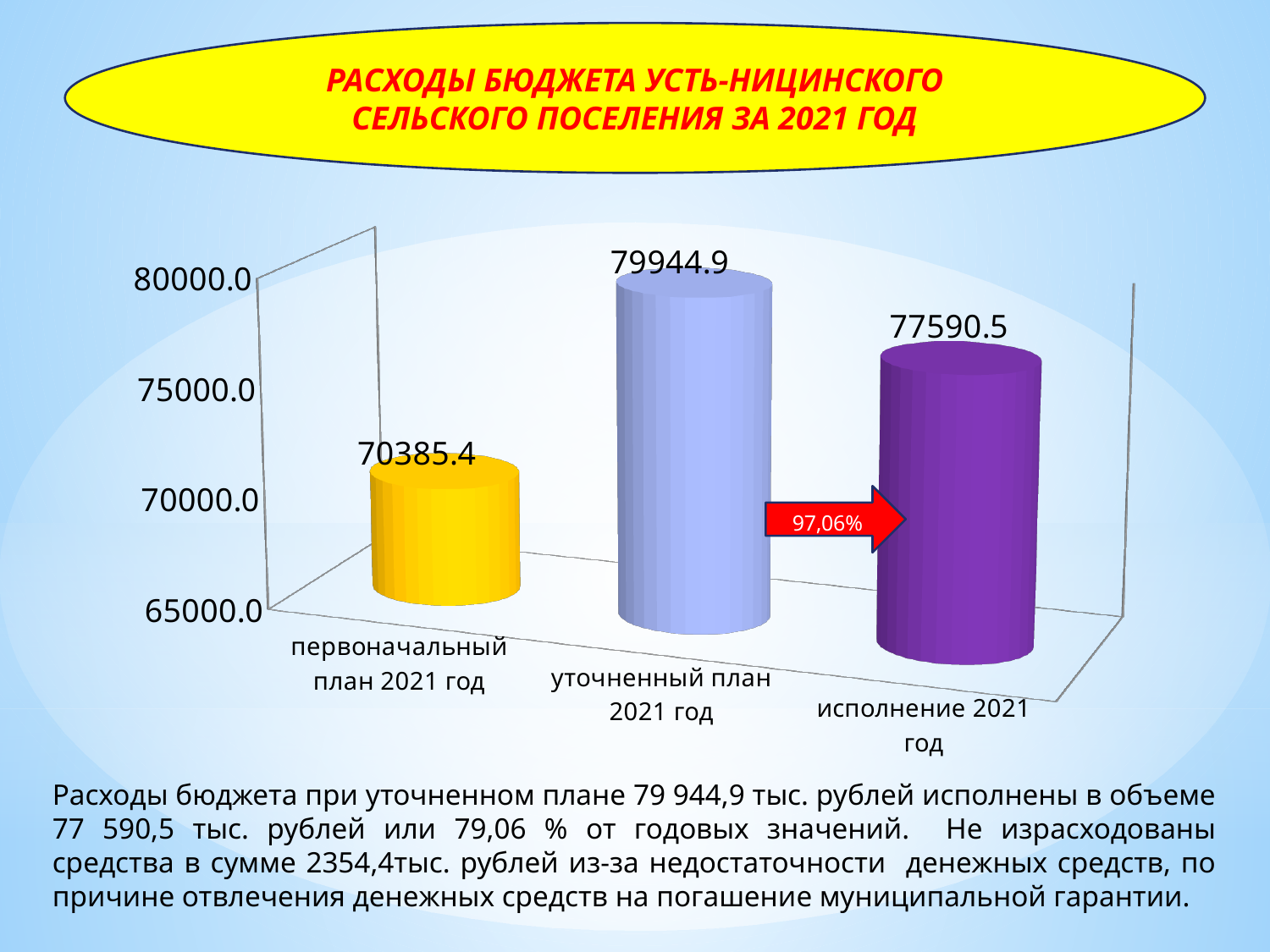
Which category has the lowest value? первоначальный план 2021 год What kind of chart is shown on the slide? bar chart Which category has the highest value? уточненный план 2021 год Is the value for «первоначальный план 2021 год» greater or less than 75000.0? less How many categories are shown in the chart? 3 What percentage is shown on the red arrow between the second and third bars? 97,06% What is the value for «первоначальный план 2021 год»? 70385.4 What is the difference between «уточненный план 2021 год» and «первоначальный план 2021 год»? 9559.5 What is the value for «уточненный план 2021 год»? 79944.9 What is the value for «исполнение 2021 год»? 77590.5 What is the difference between «уточненный план 2021 год» and «исполнение 2021 год»? 2354.4 Which is larger: «исполнение 2021 год» or «первоначальный план 2021 год»? исполнение 2021 год